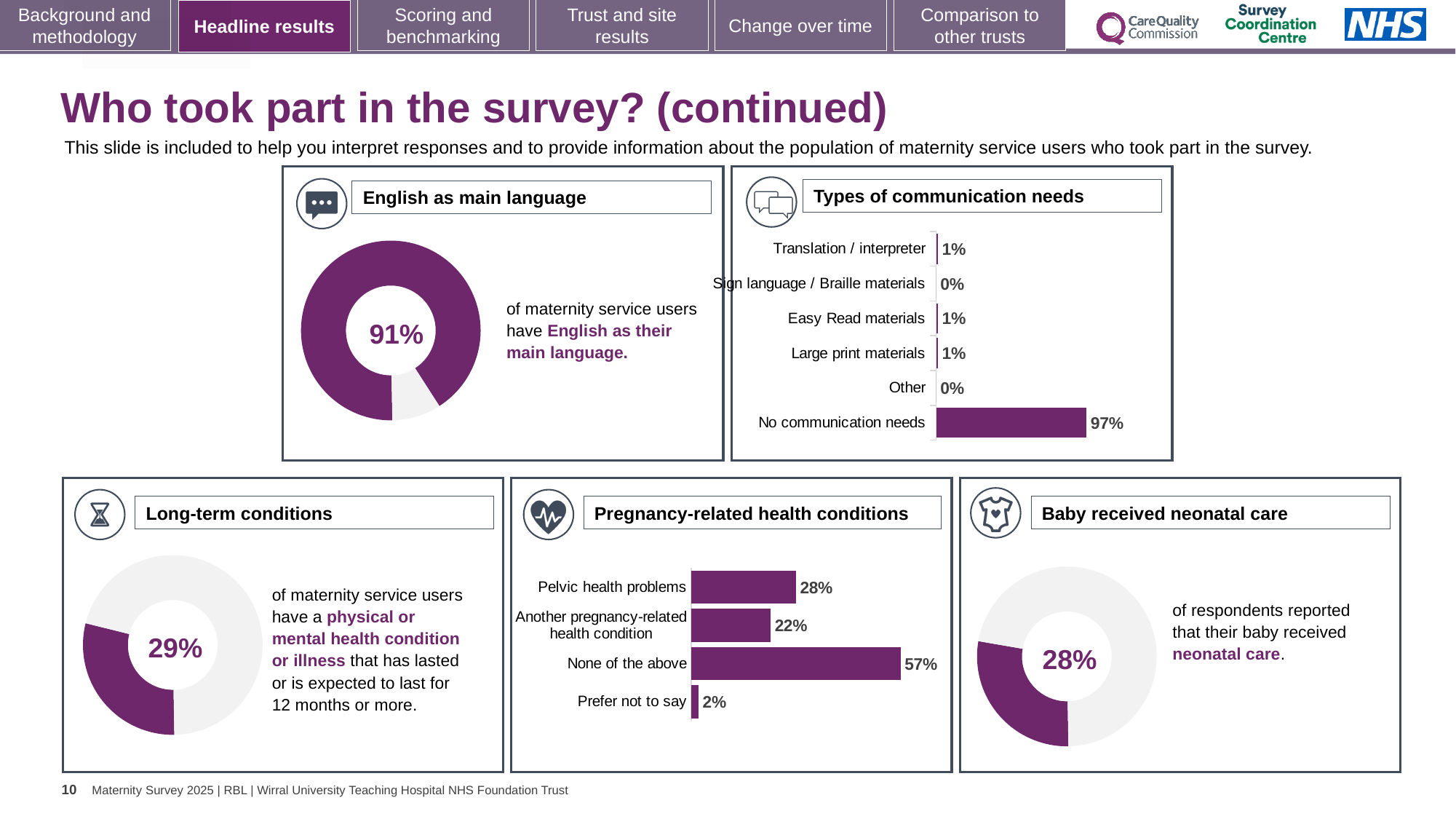
In the 'Pregnancy-related health conditions' chart, what is the value for 'Pelvic health problems'? 28% In the 'Long-term conditions' chart, what percentage of maternity service users have a physical or mental health condition or illness? 29% What kind of chart is the 'Types of communication needs' chart? Bar chart In the 'Baby received neonatal care' chart, what percentage of respondents reported that their baby received neonatal care? 28% In the 'English as main language' chart, what percentage of maternity service users have English as their main language? 91% In the 'Types of communication needs' chart, which category has the highest value? No communication needs In the 'Types of communication needs' chart, what is the value for 'No communication needs'? 97% How many categories are shown in the 'Types of communication needs' chart? 6 In the 'Types of communication needs' chart, what is the value for 'Translation / interpreter'? 1% In the 'Pregnancy-related health conditions' chart, which category has the lowest value? Prefer not to say In the 'Pregnancy-related health conditions' chart, what is the difference between 'None of the above' and 'Another pregnancy-related health condition'? 35% In the 'Pregnancy-related health conditions' chart, which is larger: 'Pelvic health problems' or 'Another pregnancy-related health condition'? Pelvic health problems